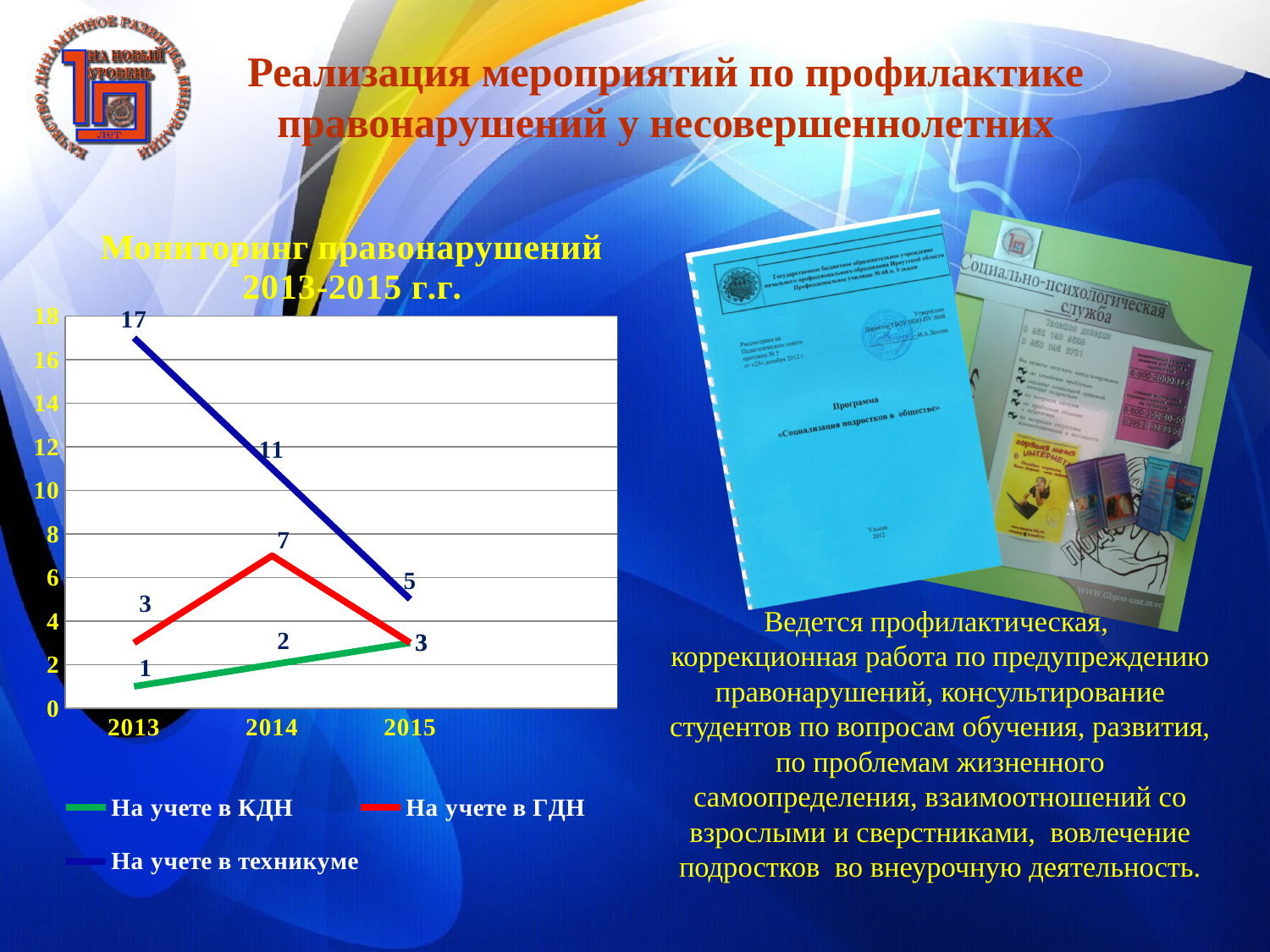
What is the title of the chart? Мониторинг правонарушений 2013-2015 г.г. What is the value for "На учете в ГДН" in 2014? 7 In which year is the value for "На учете в техникуме" the highest? 2013 Does the value for "На учете в техникуме" rise or fall from 2013 to 2015? fall What is the value for "На учете в техникуме" in 2015? 5 Which is larger in 2014: "На учете в ГДН" or "На учете в КДН"? На учете в ГДН How many series does the legend list? 3 What is the difference between the "На учете в техникуме" values in 2013 and 2015? 12 In which year is the value for "На учете в КДН" the lowest? 2013 What kind of chart is shown on the slide? line chart What is the value for "На учете в техникуме" in 2013? 17 What is the value for "На учете в КДН" in 2015? 3